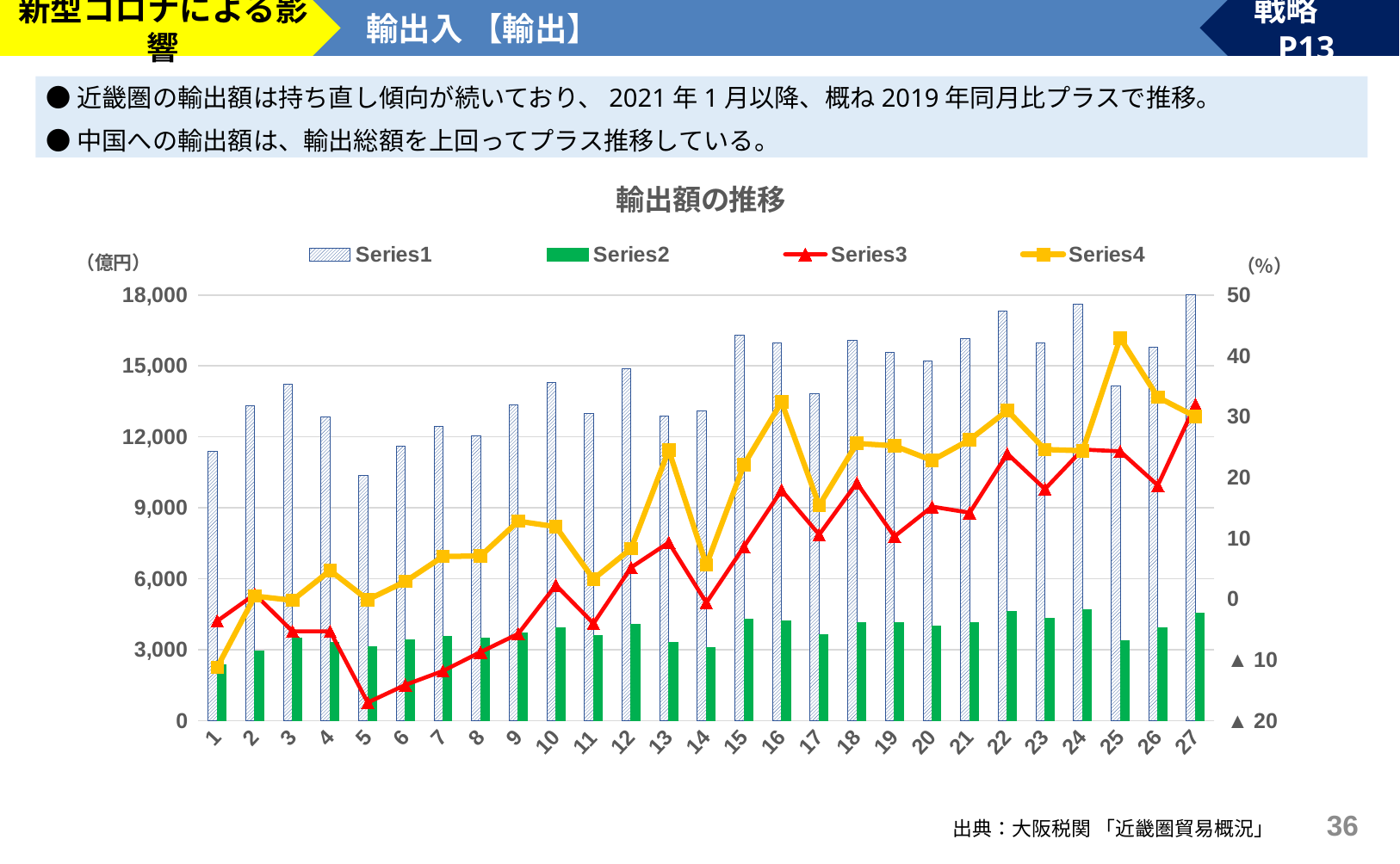
At which category is Series3 lowest? 5 Is the value of Series4 at category 25 greater or less than 40? greater What is the title of the chart? 輸出額の推移 Which series is drawn as a red line with triangle markers? Series3 What kind of chart is shown on the slide? Combined bar and line chart How many series does the legend list? 4 Which is larger for Series1: category 3 or category 5? Category 3 How many categories are shown on the x axis? 27 Is the value of Series1 at category 5 greater or less than 12,000? less At which category is Series1 lowest? 5 Does Series4 generally rise or fall from category 1 to category 27? Rise At which category is Series4 highest? 25